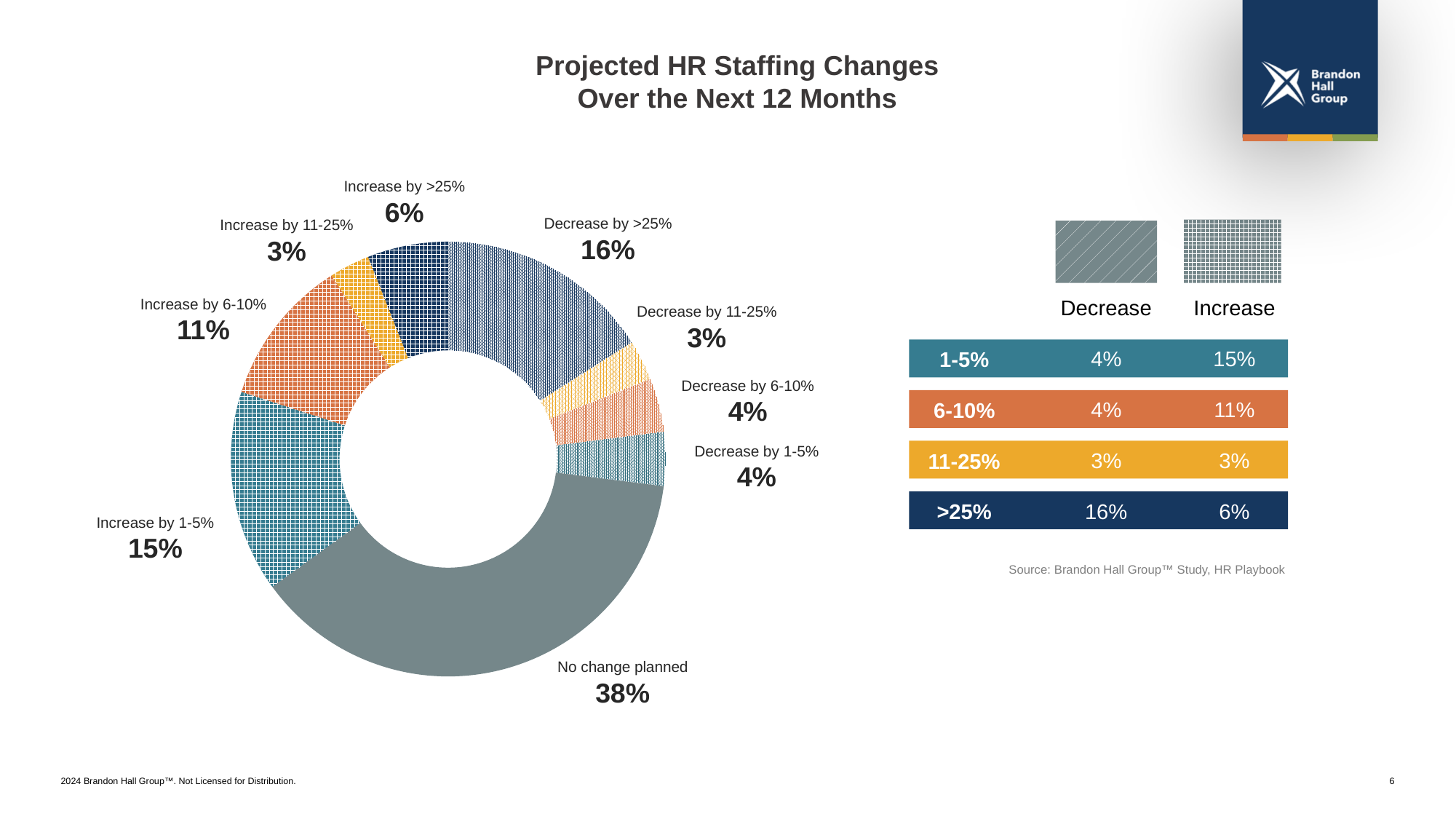
What is the value for 'Increase by 6-10%'? 11% What percentage of respondents have no change planned? 38% What is the value for 'Increase by 11-25%'? 3% Which category has the largest share of the chart? No change planned What kind of chart is shown on the slide? Pie chart (donut) What is the combined share of all 'Increase' categories? 35% Which is larger, 'Decrease by >25%' or 'Increase by >25%'? Decrease by >25% According to the legend, which pattern represents 'Decrease'? Diagonal stripes What is the value for 'Decrease by >25%'? 16% What is the title of the chart? Projected HR Staffing Changes Over the Next 12 Months What is the difference between 'Increase by 1-5%' and 'Decrease by 1-5%'? 11 percentage points How many categories (slices) does the chart show? 9